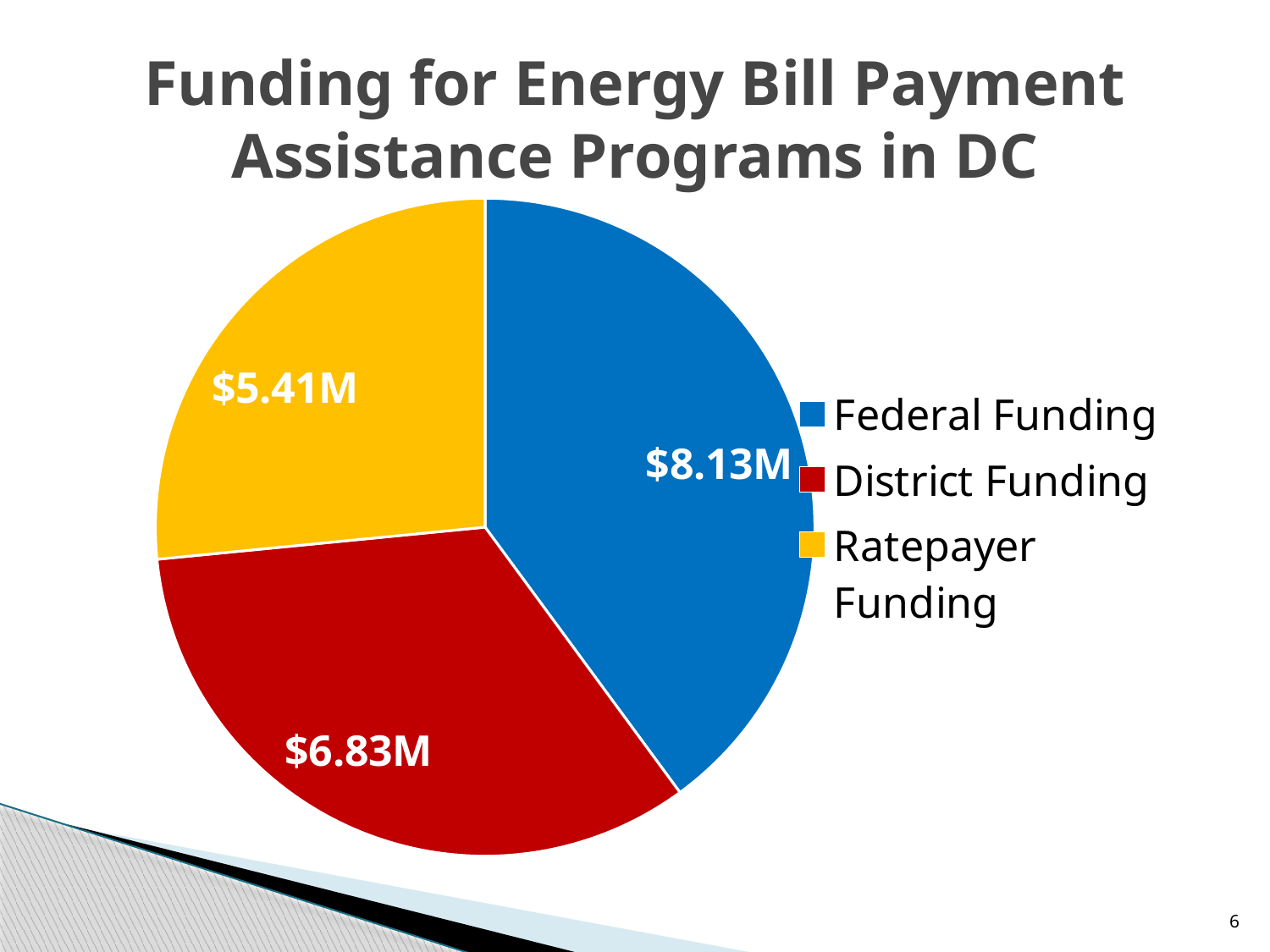
What is the value for District Funding? $6.83M How many slices does the pie chart have? 3 What is the value for Federal Funding? $8.13M What is the difference between Federal Funding and District Funding? $1.30M Which funding source has the largest value? Federal Funding What is the title of the chart? Funding for Energy Bill Payment Assistance Programs in DC What is the value for Ratepayer Funding? $5.41M Which funding source has the smallest value? Ratepayer Funding Which is larger, District Funding or Ratepayer Funding? District Funding Which colour represents Ratepayer Funding in the chart? Yellow What type of chart is shown on the slide? Pie chart How many entries does the legend list? 3